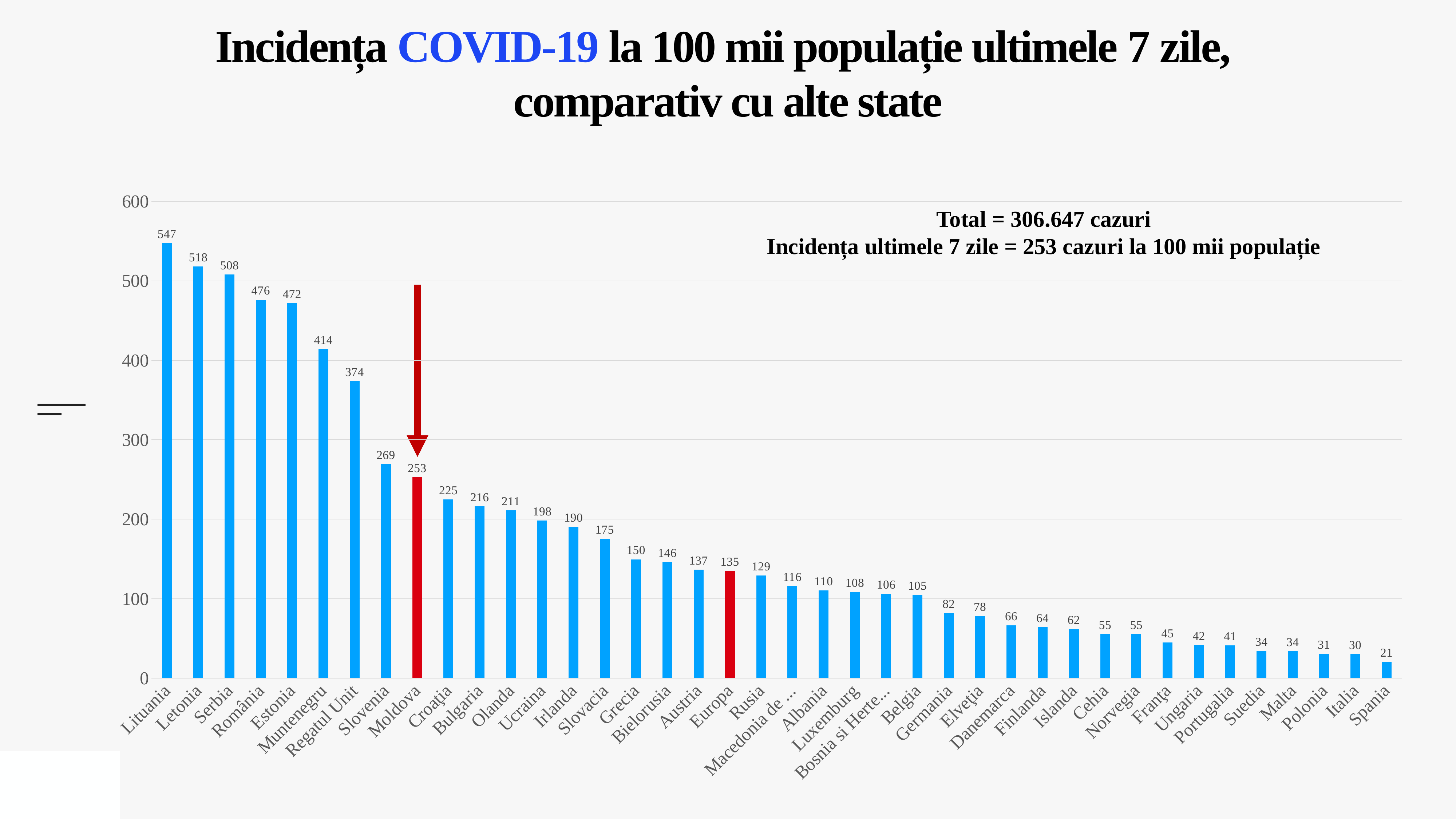
What is the difference between the values for Lituania and Letonia? 29 What is the value for Europa? 135 What is the value for Regatul Unit? 374 Which country has the highest value? Lituania Which country has the lowest value? Spania How many countries or regions are shown on the chart? 40 Is the value for Muntenegru greater or less than 400? greater Do the values rise or fall from left to right along the x axis? fall Which has a larger value, Slovenia or Croația? Slovenia What is the value for Moldova? 253 What kind of chart is shown on the slide? bar chart What is the difference between the values for Moldova and Europa? 118